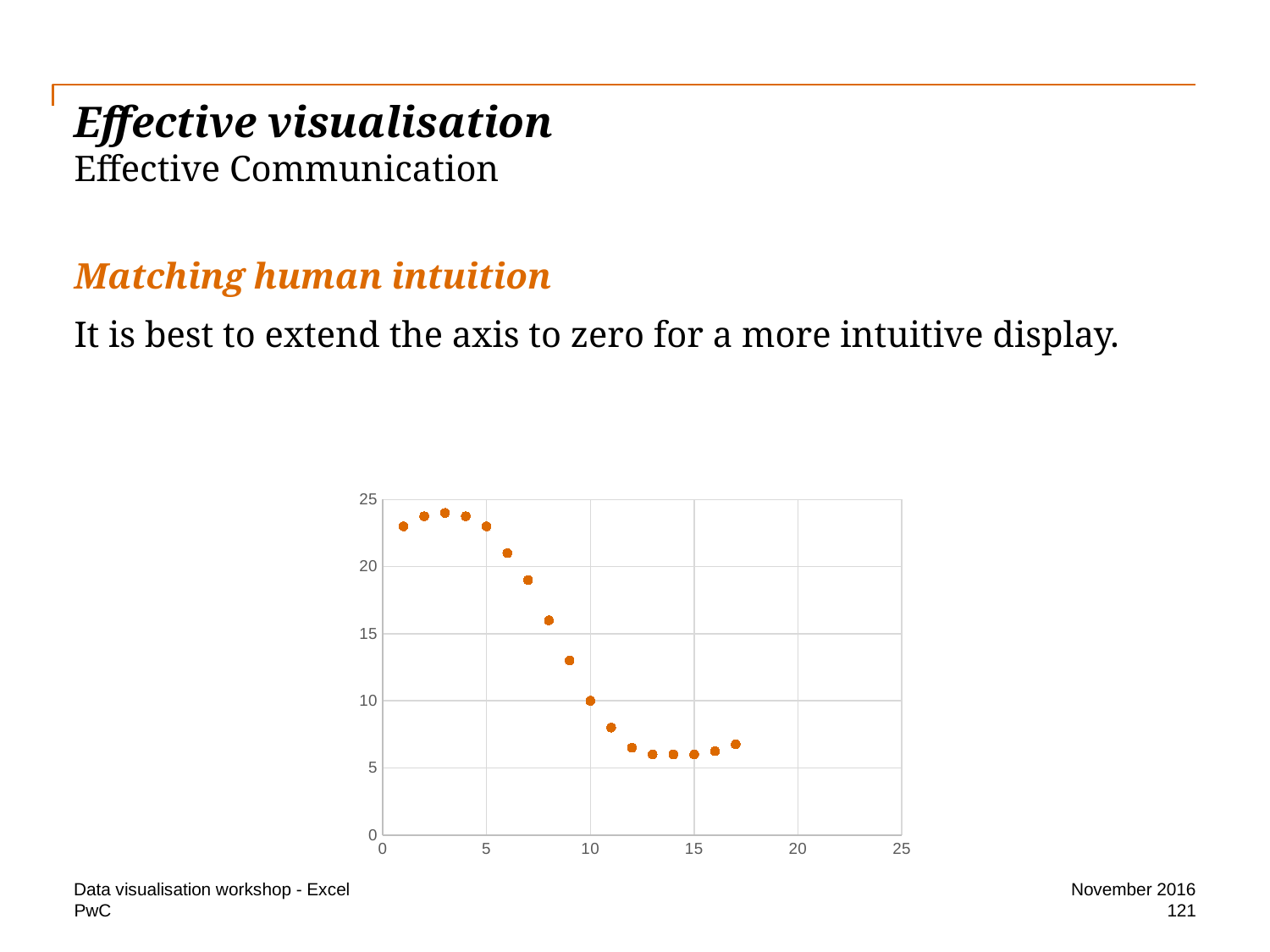
What kind of chart is shown on the slide? scatter chart Is the value of the point at x = 11 greater or less than 10? less Do the plotted values generally rise or fall as x increases from 1 to 15? fall What value does the vertical axis start at? 0 How many data points are plotted on the chart? 17 Is the value of the point at x = 1 greater or less than 20? greater Is the value of the point at x = 14 greater or less than 5? greater Which point has the larger value, the one at x = 6 or the one at x = 12? x = 6 What is the highest tick label shown on the horizontal axis? 25 Which point has the larger value, the one at x = 1 or the one at x = 17? x = 1